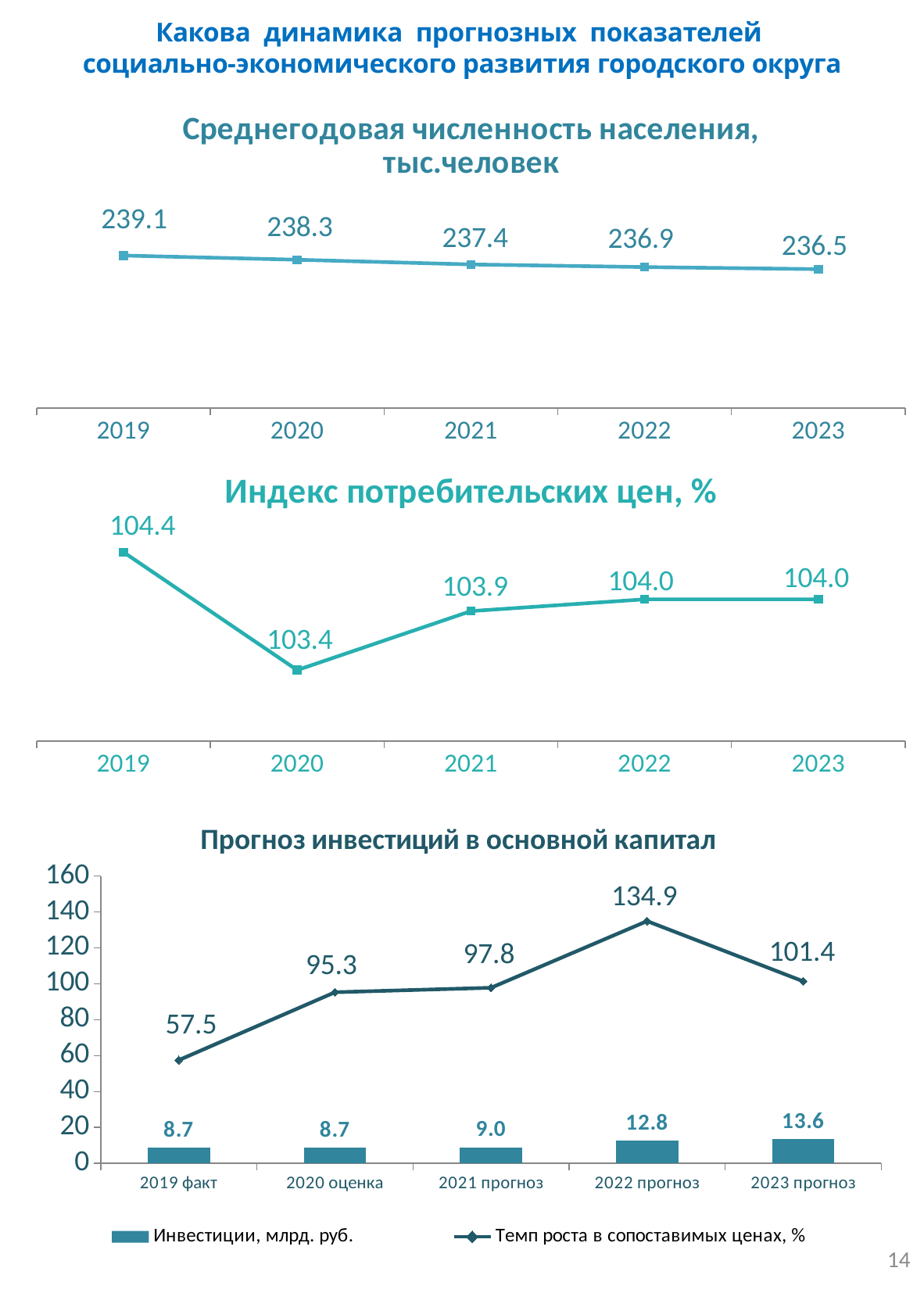
In the chart 'Прогноз инвестиций в основной капитал', which category has the highest value of 'Темп роста в сопоставимых ценах, %'? 2022 прогноз In the chart 'Среднегодовая численность населения, тыс.человек', which year has the lowest value? 2023 In the chart 'Среднегодовая численность населения, тыс.человек', what is the value for 2021? 237.4 In the chart 'Индекс потребительских цен, %', which year has the highest value? 2019 In the chart 'Среднегодовая численность населения, тыс.человек', what is the difference between the 2019 and 2023 values? 2.6 In the chart 'Среднегодовая численность населения, тыс.человек', do the values rise or fall from 2019 to 2023? fall In the chart 'Прогноз инвестиций в основной капитал', is the value of 'Темп роста в сопоставимых ценах, %' for 2023 прогноз larger or smaller than for 2022 прогноз? smaller In the chart 'Индекс потребительских цен, %', what is the value for 2020? 103.4 In the chart 'Прогноз инвестиций в основной капитал', what is the value of 'Инвестиции, млрд. руб.' for 2022 прогноз? 12.8 In the chart 'Прогноз инвестиций в основной капитал', how many series does the legend list? 2 In the chart 'Прогноз инвестиций в основной капитал', what is the value of 'Темп роста в сопоставимых ценах, %' for 2019 факт? 57.5 In the chart 'Индекс потребительских цен, %', how many years are plotted? 5